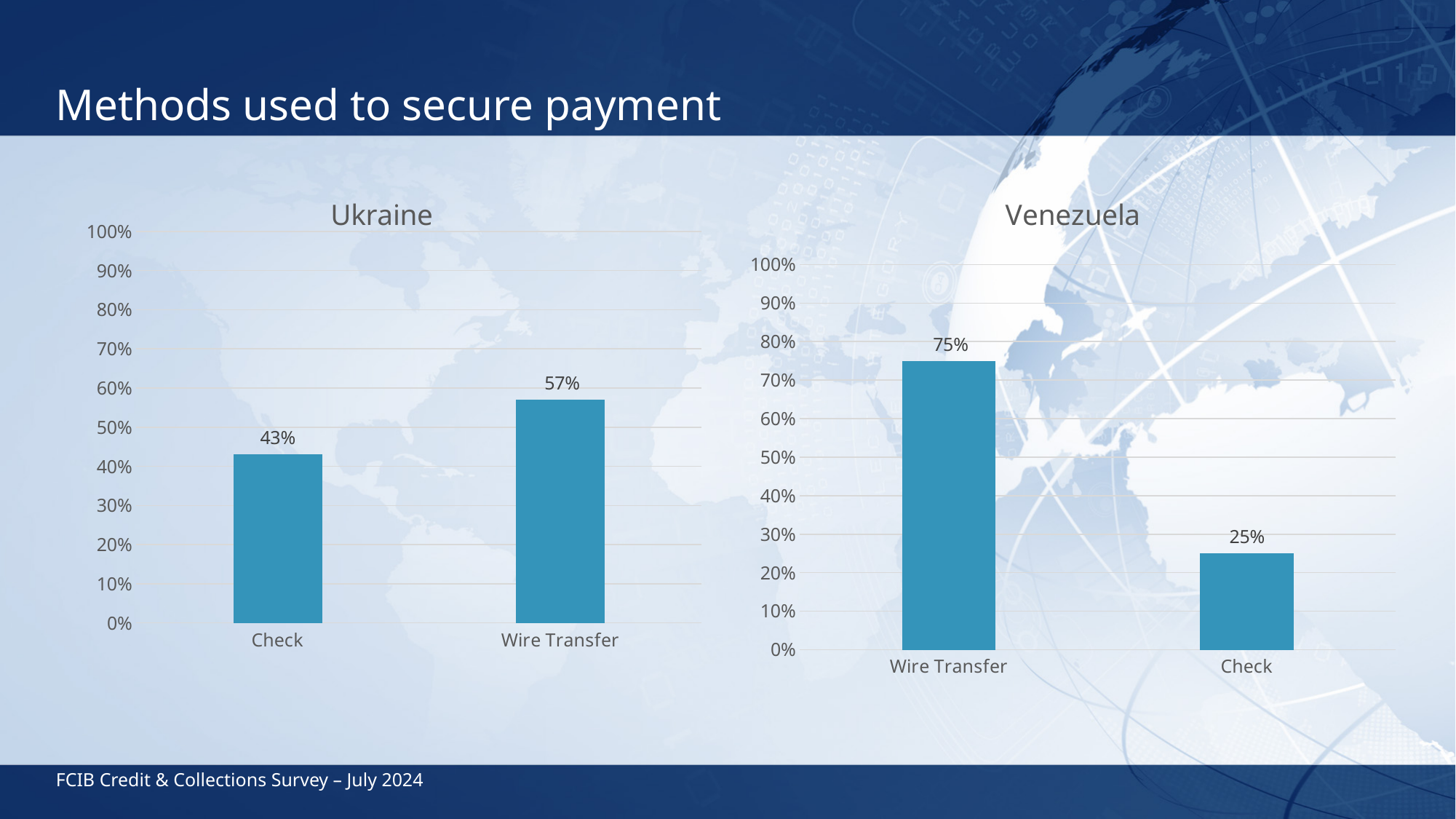
In the Venezuela chart, what is the value for Check? 25% In the Ukraine chart, what is the value for Wire Transfer? 57% How many categories are shown in the Venezuela chart? 2 In the Venezuela chart, which category has the lowest value? Check In the Ukraine chart, which category has the highest value? Wire Transfer In the Ukraine chart, what is the value for Check? 43% In the Ukraine chart, is the value for Check greater or less than 50%? less What kind of chart is the Ukraine chart? Bar chart In the Ukraine chart, what is the difference between Wire Transfer and Check? 14% In the Venezuela chart, what is the difference between Wire Transfer and Check? 50% Which is larger: Wire Transfer in the Ukraine chart or Wire Transfer in the Venezuela chart? Wire Transfer in the Venezuela chart In the Venezuela chart, what is the value for Wire Transfer? 75%